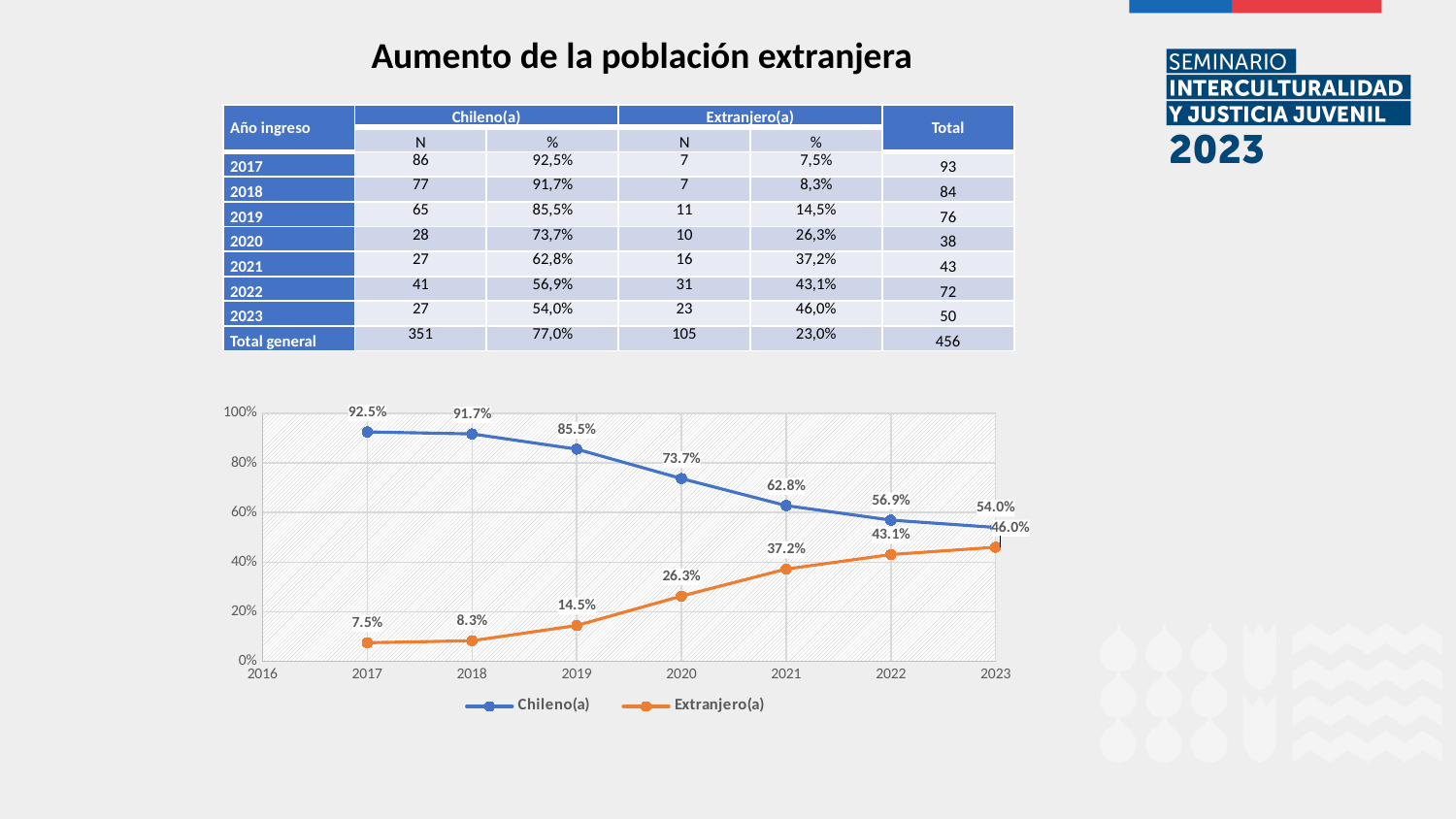
How many series does the chart legend list? 2 What is the value for Extranjero(a) in 2021 on the chart? 37.2% In which year is the Extranjero(a) value lowest on the chart? 2017 In which year is the Chileno(a) value highest on the chart? 2017 What colour is the Extranjero(a) line on the chart? Orange Does the Extranjero(a) series rise or fall from 2017 to 2023 on the chart? Rise Which series has the larger value in 2020 on the chart, Chileno(a) or Extranjero(a)? Chileno(a) How many data points are plotted for the Chileno(a) series on the chart? 7 What is the value for Extranjero(a) in 2023 on the chart? 46.0% What is the value for Chileno(a) in 2017 on the chart? 92.5% What type of chart is shown on the slide? Line chart What is the difference between the Chileno(a) and Extranjero(a) values in 2023 on the chart? 8.0%